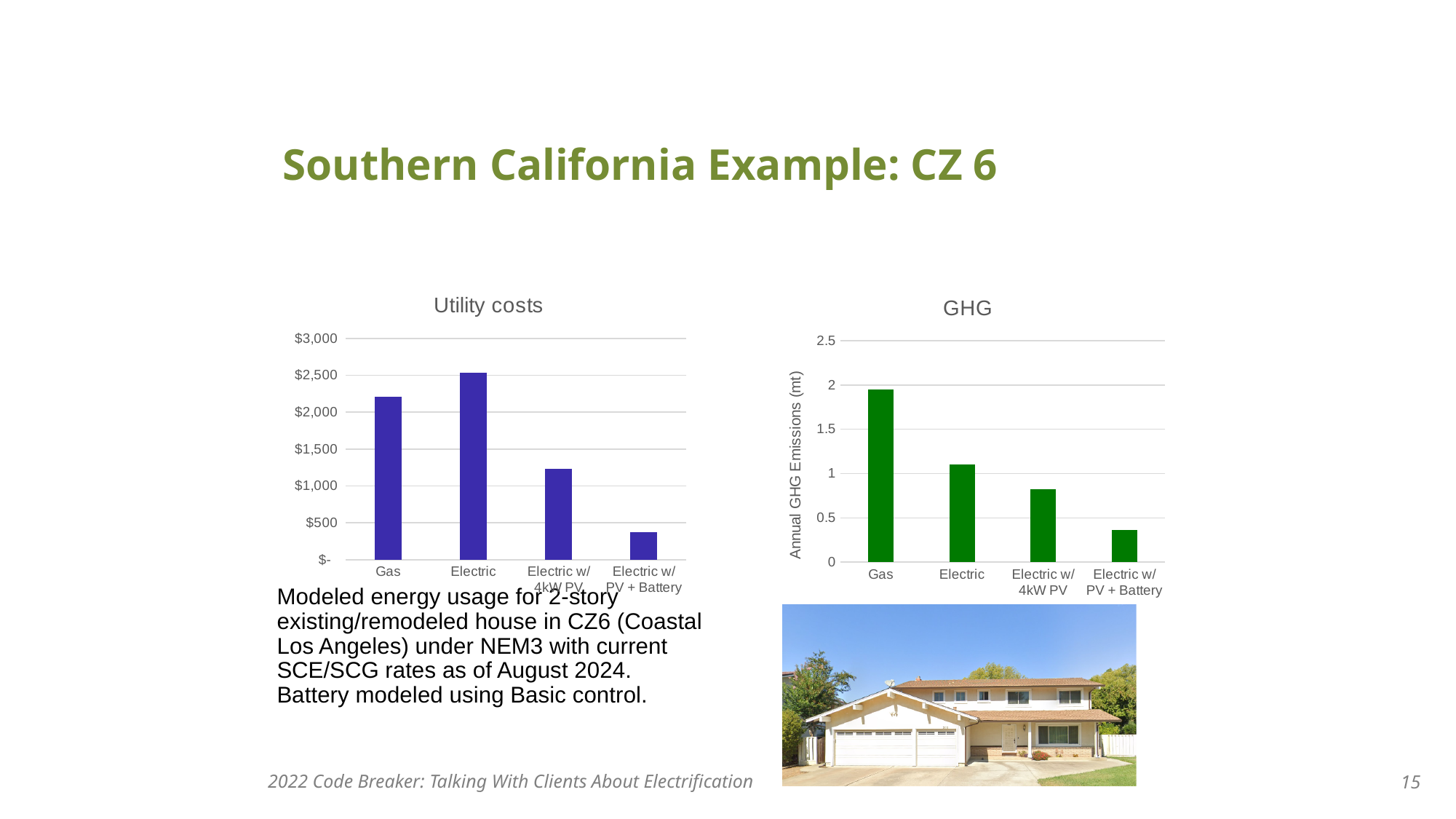
In the GHG chart, which category has the highest value? Gas What is the y-axis label of the GHG chart? Annual GHG Emissions (mt) In the GHG chart, which category has the lowest value? Electric w/ PV + Battery In the GHG chart, is the value for Electric w/ 4kW PV greater or less than 1? less In the Utility costs chart, which category has the lowest value? Electric w/ PV + Battery In the Utility costs chart, which is larger, the value for Gas or the value for Electric w/ 4kW PV? Gas In the Utility costs chart, which category has the highest value? Electric In the GHG chart, do the values rise or fall from left to right along the x axis? fall How many categories are shown in the Utility costs chart? 4 In the Utility costs chart, is the value for Electric w/ PV + Battery greater or less than $500? less In the Utility costs chart, is the value for Gas greater or less than $2,000? greater What kind of chart is the GHG chart? bar chart